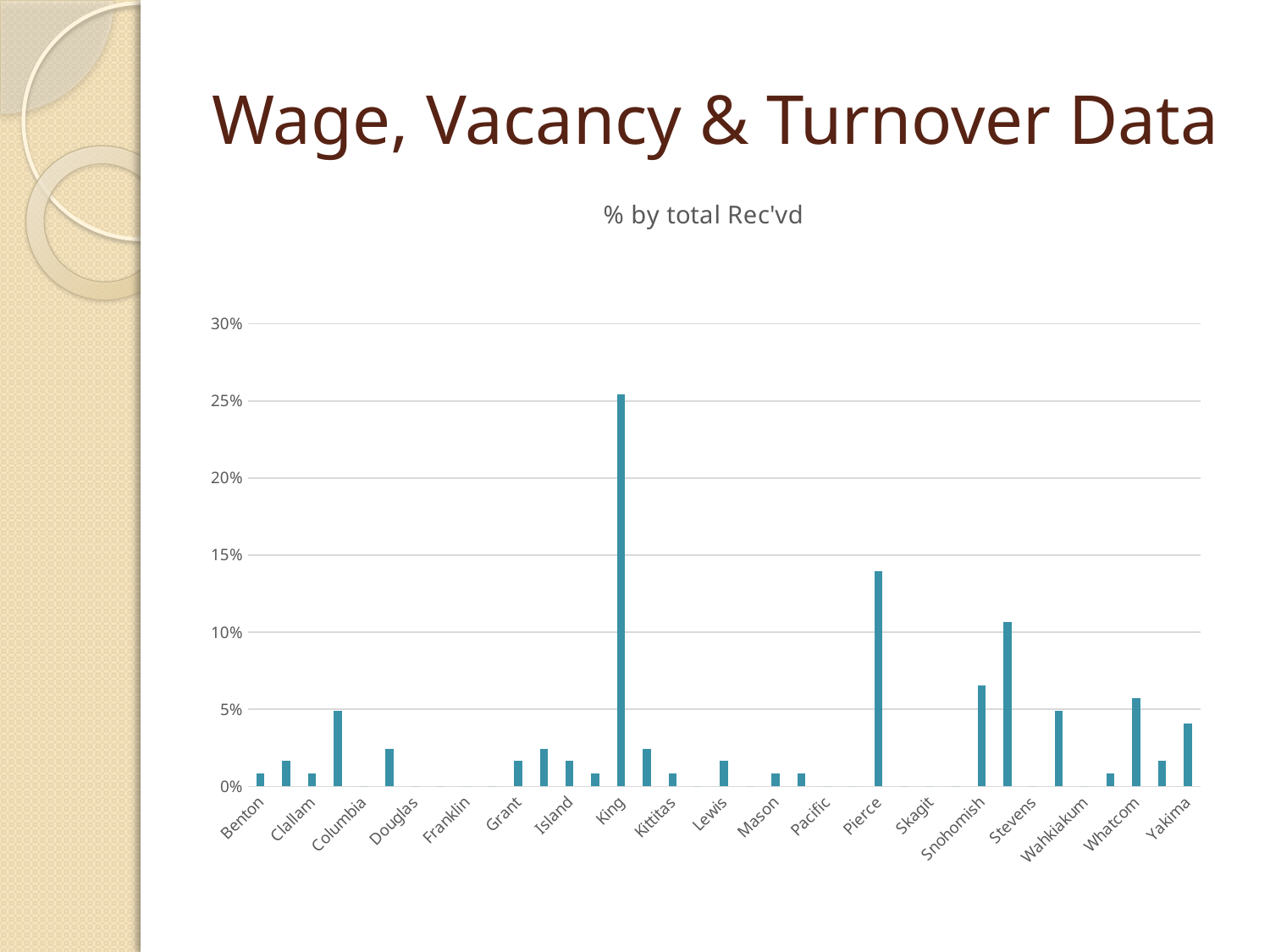
Is the value for Pierce greater or less than 10%? greater What is the title of the chart? % by total Rec'vd Is the value for Benton greater or less than 5%? less Is the value for King greater or less than 20%? greater Which has a larger value, King or Pierce? King What type of chart is shown on the slide? bar chart Which county has the highest value in the chart? King What is the highest value shown on the vertical axis? 30% Which has a larger value, Pierce or Benton? Pierce